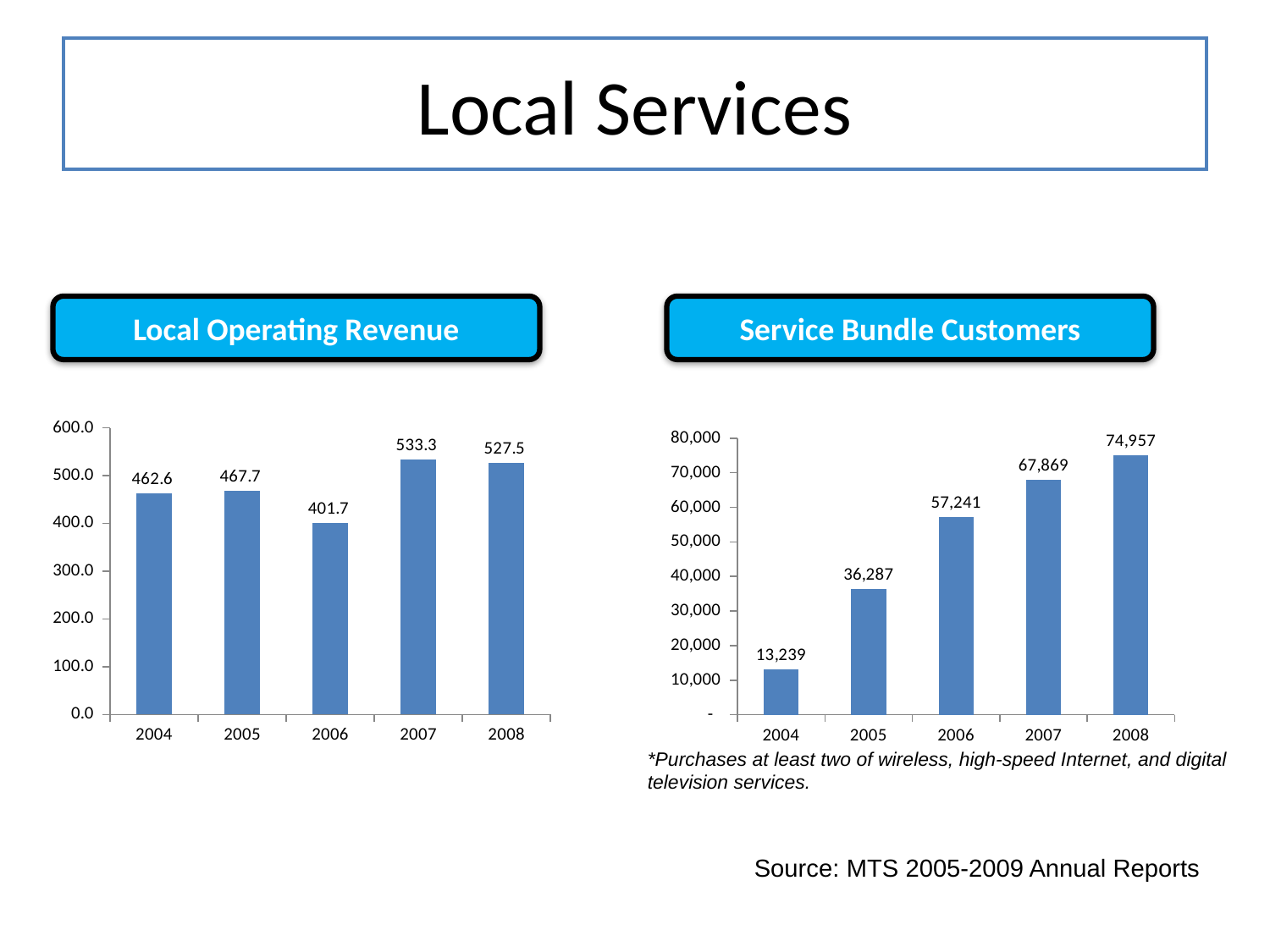
In the Local Operating Revenue chart, is the value for 2005 greater or less than 500.0? less In the Service Bundle Customers chart, what is the difference between the 2007 and 2006 values? 10,628 In the Local Operating Revenue chart, what is the difference between the 2007 and 2008 values? 5.8 How many years are shown on the x axis of the Service Bundle Customers chart? 5 In the Local Operating Revenue chart, what is the value for 2006? 401.7 In the Service Bundle Customers chart, do the values rise or fall from 2004 to 2008? rise In the Service Bundle Customers chart, what is the value for 2008? 74,957 In the Local Operating Revenue chart, which year has the highest value? 2007 In the Local Operating Revenue chart, which year has the lowest value? 2006 What kind of chart is the Local Operating Revenue chart? bar chart In the Service Bundle Customers chart, which year has the lowest value? 2004 In the Service Bundle Customers chart, what is the value for 2005? 36,287